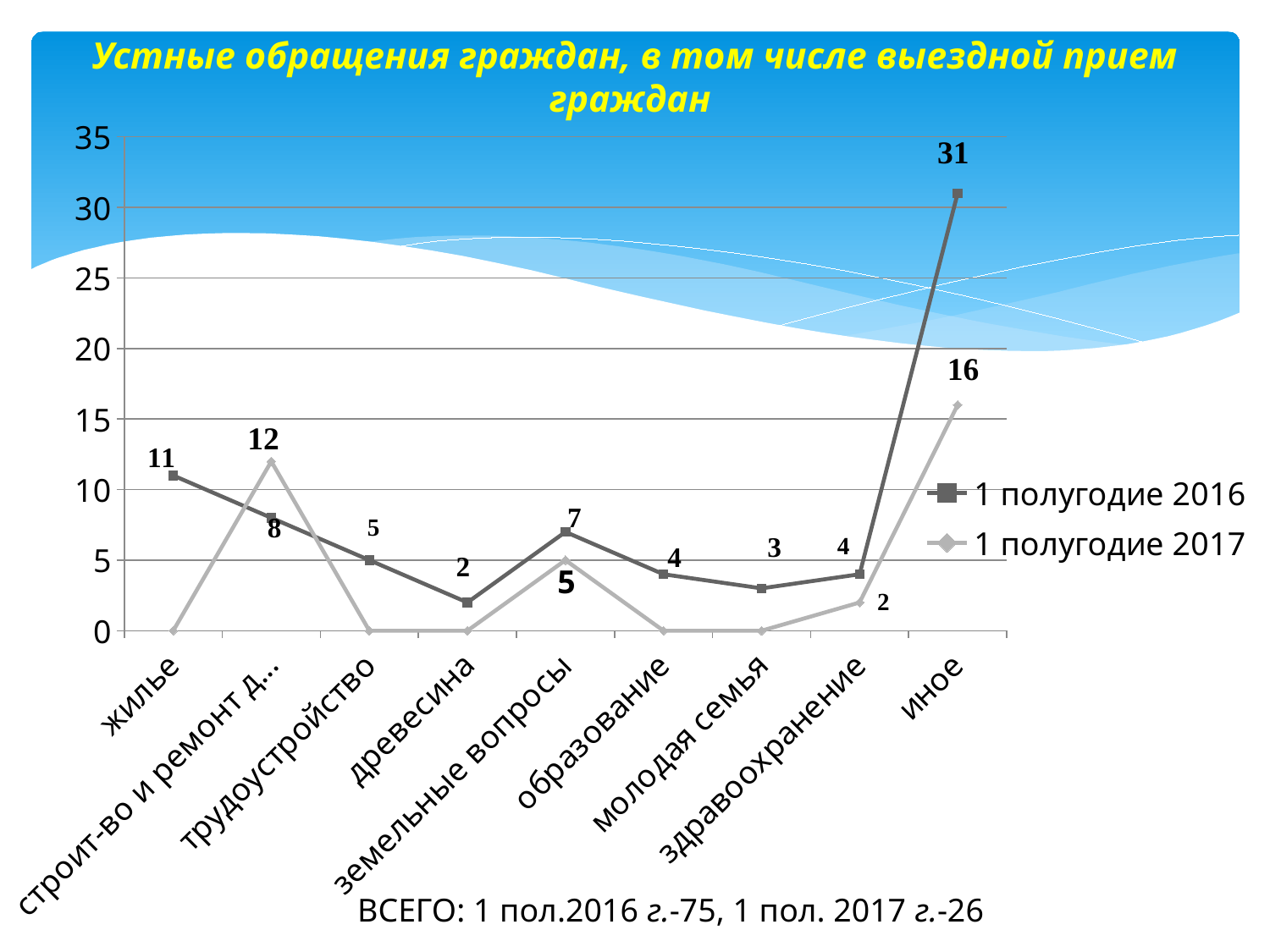
Which category has the highest value in the "1 полугодие 2016" series? иное What is the value for "иное" in the "1 полугодие 2017" series? 16 Is the value for "иное" in the "1 полугодие 2016" series greater or less than 30? greater How many categories are shown on the x axis? 9 Which category has the lowest value in the "1 полугодие 2016" series? древесина What is the value for "иное" in the "1 полугодие 2016" series? 31 What kind of chart is shown on the slide? line chart What is the value for "жилье" in the "1 полугодие 2016" series? 11 For "земельные вопросы", which series has the larger value, "1 полугодие 2016" or "1 полугодие 2017"? 1 полугодие 2016 What is the difference between the "1 полугодие 2016" and "1 полугодие 2017" values for "иное"? 15 What is the title of the chart? Устные обращения граждан, в том числе выездной прием граждан How many series does the legend list? 2